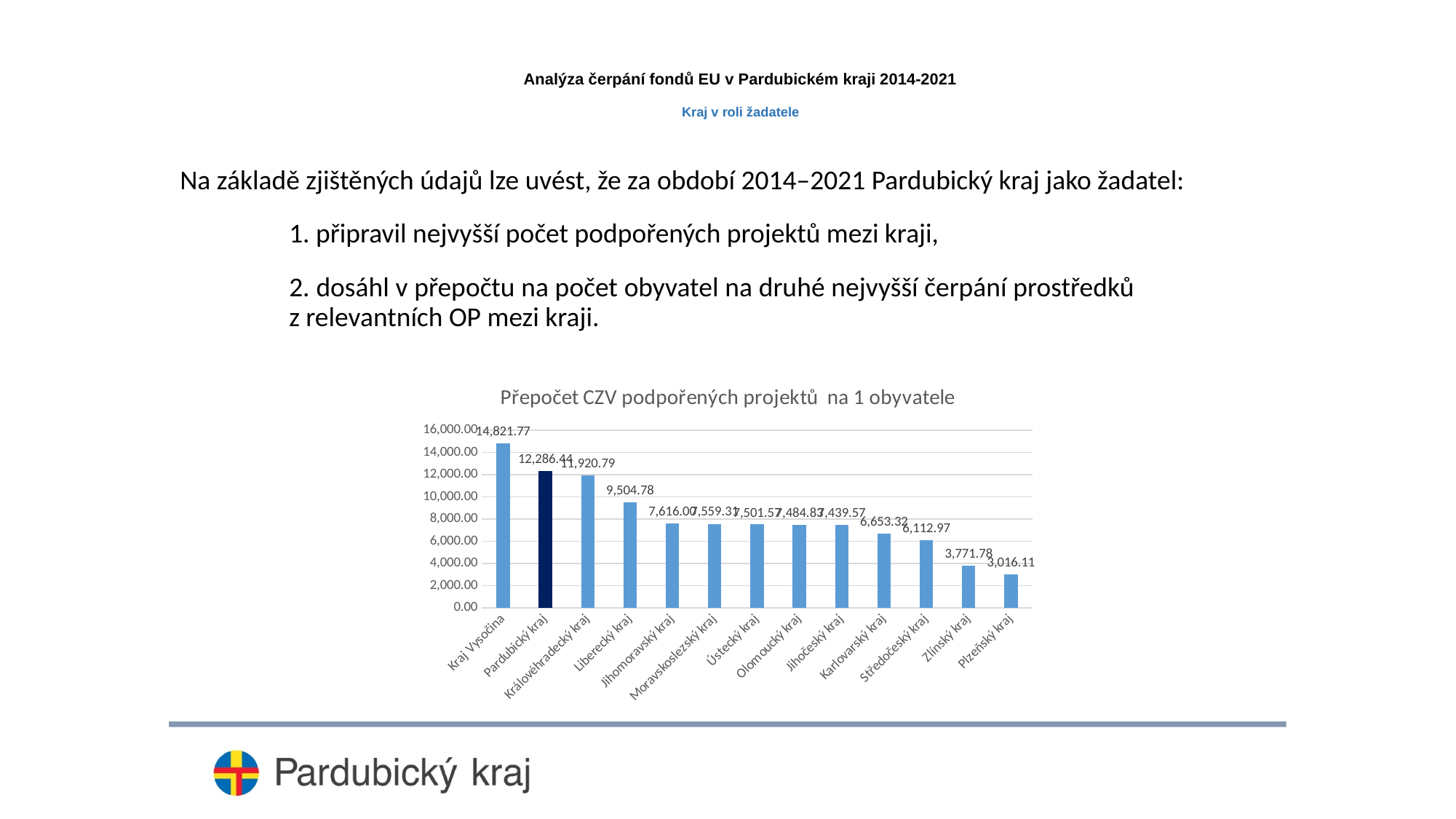
What is the value shown for Kraj Vysočina? 14,821.77 What is the value shown for Liberecký kraj? 9,504.78 Do the values rise or fall from left to right along the x axis? fall Which has the larger value, Karlovarský kraj or Středočeský kraj? Karlovarský kraj How many regions are shown on the x axis of the chart? 13 Which region's bar is drawn in a dark navy colour, unlike the others? Pardubický kraj What type of chart is shown on the slide? bar chart Which region has the lowest value in the chart? Plzeňský kraj What is the value shown for Pardubický kraj? 12,286.44 Which region has the highest value in the chart? Kraj Vysočina What is the value shown for Zlínský kraj? 3,771.78 What is the difference between the values for Kraj Vysočina and Pardubický kraj? 2,535.33